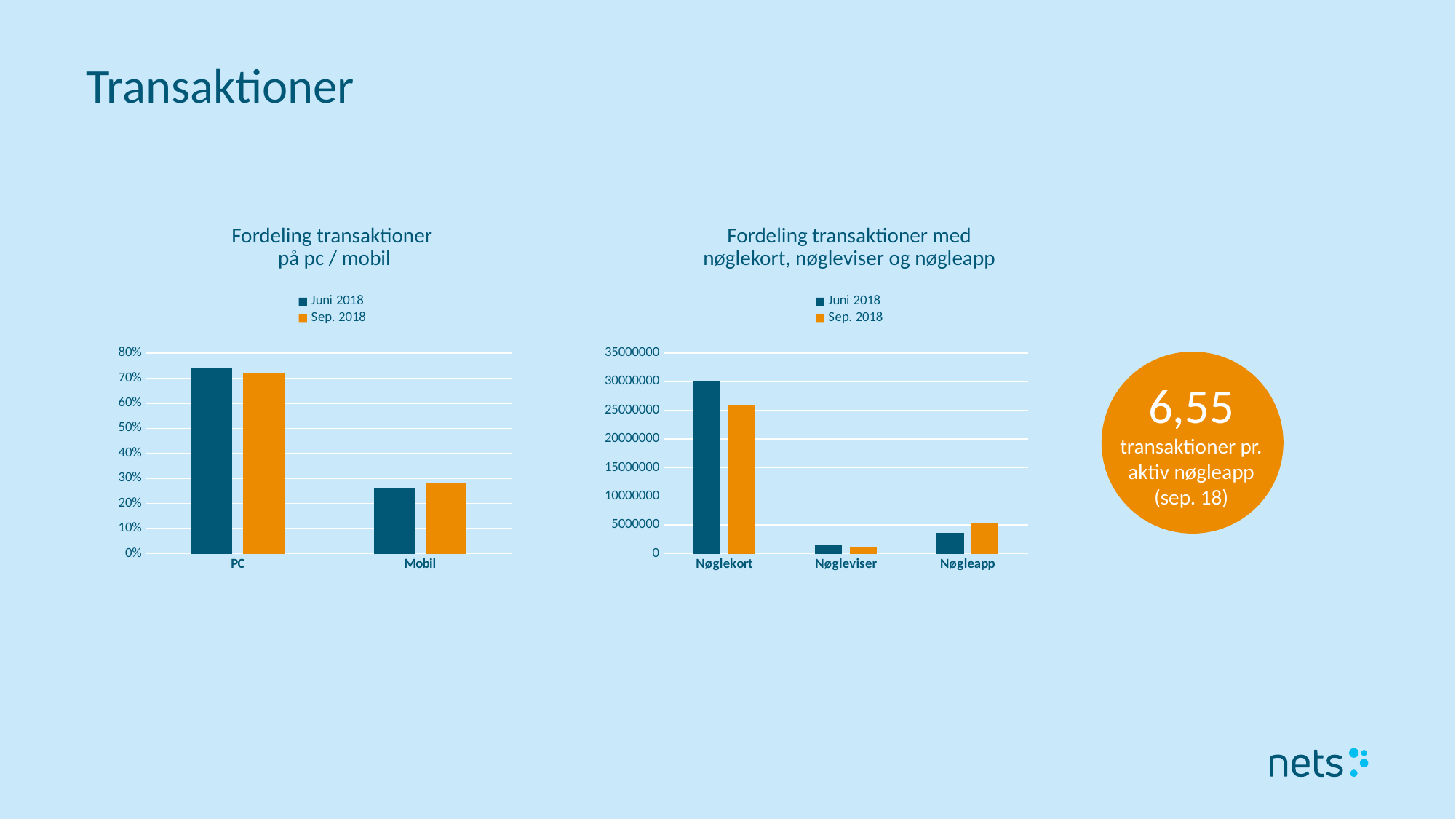
What kind of chart is the 'Fordeling transaktioner på pc / mobil' chart? bar chart What are the two legend entries of the 'Fordeling transaktioner med nøglekort, nøgleviser og nøgleapp' chart? Juni 2018 and Sep. 2018 In the 'Fordeling transaktioner med nøglekort, nøgleviser og nøgleapp' chart, is the Sep. 2018 value for Nøgleapp greater or less than 10000000? less In the 'Fordeling transaktioner på pc / mobil' chart, is the Juni 2018 value for PC greater or less than 60%? greater How many categories are shown on the x axis of the 'Fordeling transaktioner med nøglekort, nøgleviser og nøgleapp' chart? 3 In the 'Fordeling transaktioner med nøglekort, nøgleviser og nøgleapp' chart, is the Juni 2018 value for Nøglekort greater or less than 25000000? greater In the 'Fordeling transaktioner med nøglekort, nøgleviser og nøgleapp' chart, which category has the highest Juni 2018 value? Nøglekort How many series does the legend of the 'Fordeling transaktioner på pc / mobil' chart list? 2 In the 'Fordeling transaktioner med nøglekort, nøgleviser og nøgleapp' chart, which is larger for Nøgleapp, the Juni 2018 value or the Sep. 2018 value? Sep. 2018 In the 'Fordeling transaktioner på pc / mobil' chart, which category has the higher Juni 2018 value, PC or Mobil? PC In the 'Fordeling transaktioner med nøglekort, nøgleviser og nøgleapp' chart, which category has the lowest Sep. 2018 value? Nøgleviser